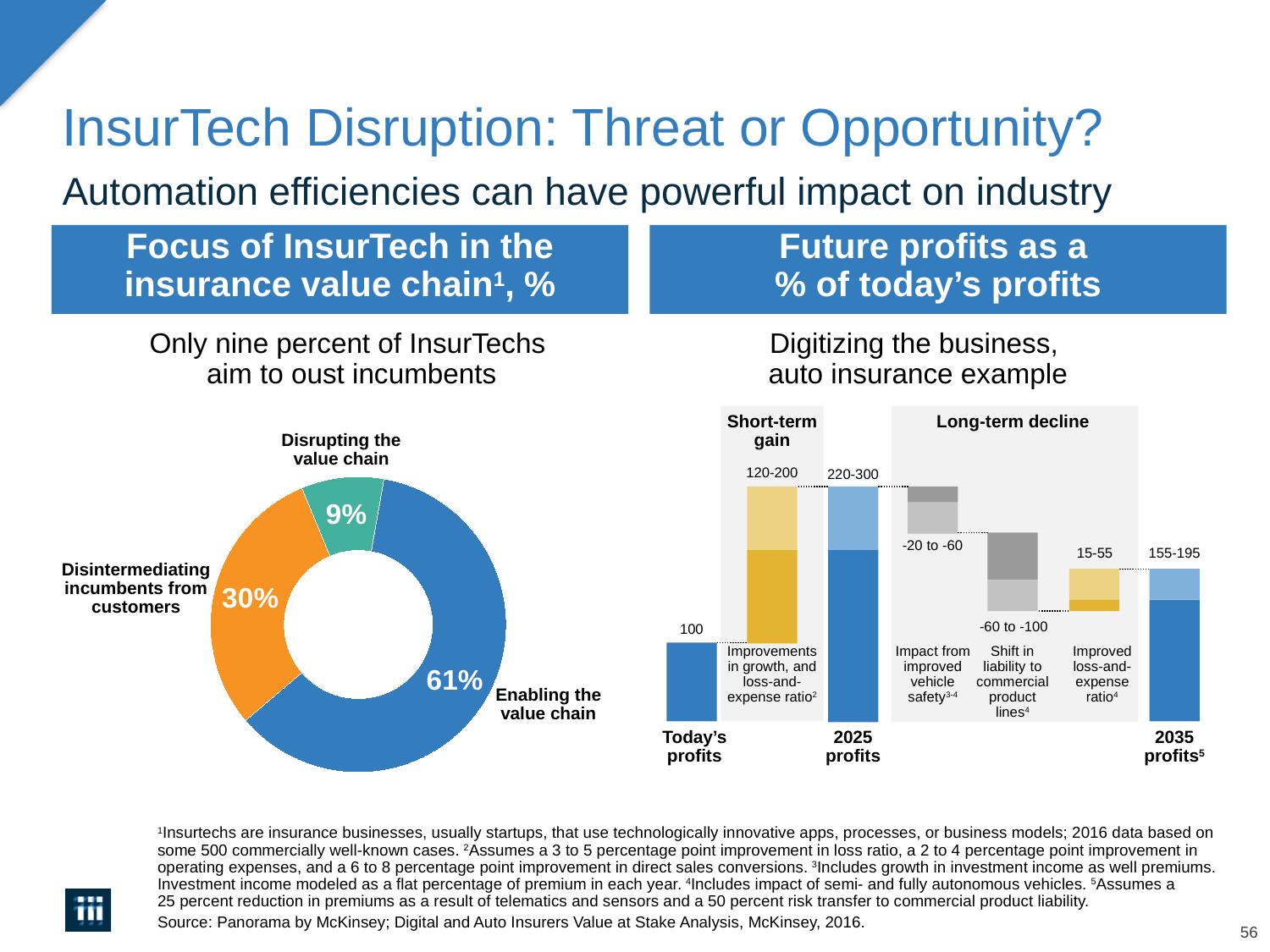
On the left chart, which category has the smallest share? Disrupting the value chain On the left chart, which category has the largest share? Enabling the value chain On the right chart, what range is shown for 2035 profits? 155-195 How many categories does the left chart show? 3 On the right chart, what is the value shown for today's profits? 100 On the left chart, what percentage of InsurTechs focus on enabling the value chain? 61% On the right chart, what range is shown for 2025 profits? 220-300 On the right chart, what range is shown for the shift in liability to commercial product lines? -60 to -100 On the left chart, what percentage of InsurTechs focus on disintermediating incumbents from customers? 30% On the left chart, what is the difference in percentage points between 'Enabling the value chain' and 'Disintermediating incumbents from customers'? 31 What kind of chart is the left chart? Donut (pie) chart On the left chart, what percentage of InsurTechs focus on disrupting the value chain? 9%